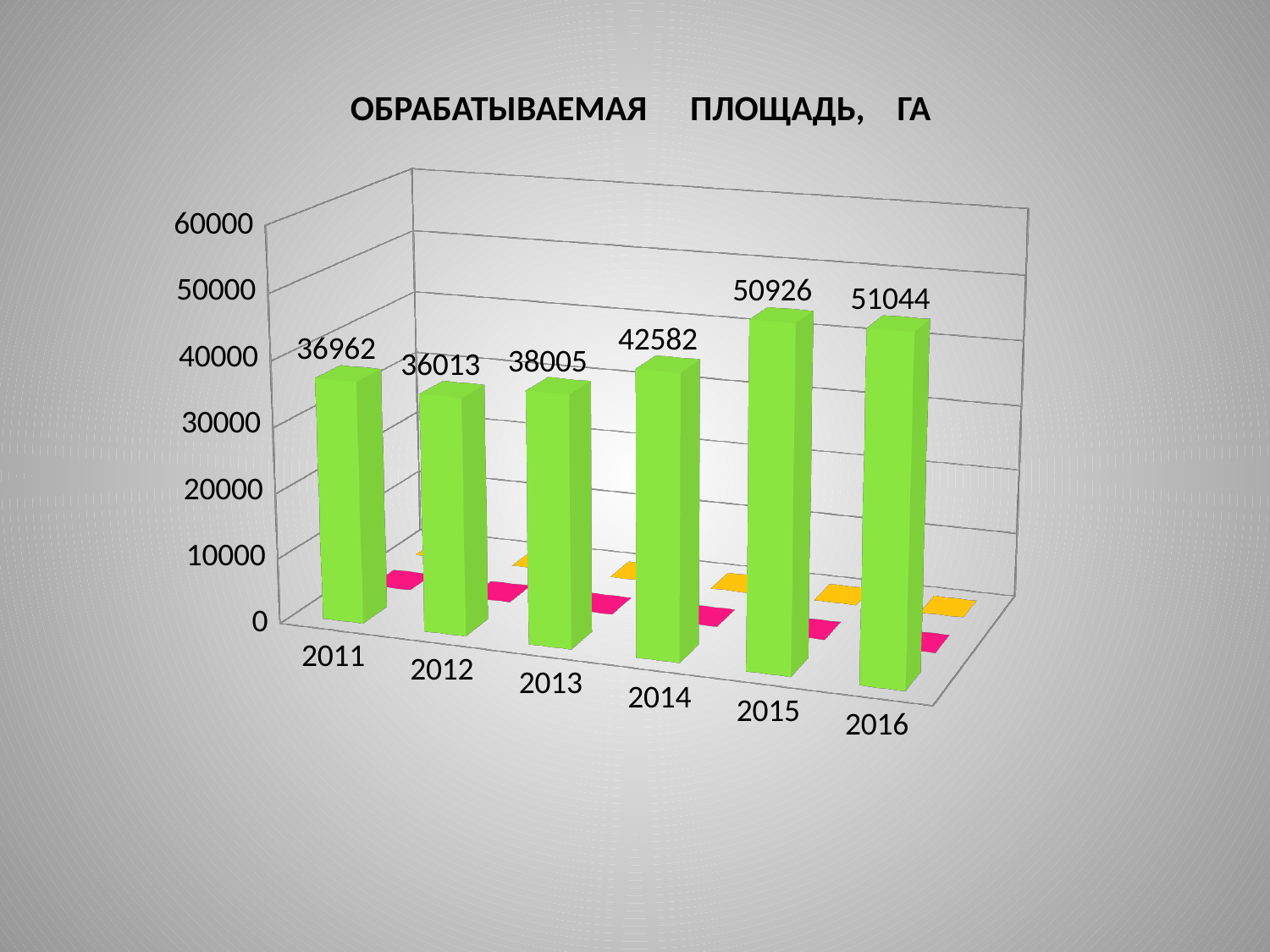
How many years are shown on the x axis? 6 What is the difference between the values for 2015 and 2014? 8344 What is the title of the chart? ОБРАБАТЫВАЕМАЯ ПЛОЩАДЬ, ГА What is the difference between the values for 2016 and 2011? 14082 What is the value for 2016? 51044 Which year has the highest value? 2016 Is the value for 2015 greater or less than 40000? greater What kind of chart is shown on the slide? bar chart What is the value for 2014? 42582 Which year has the lowest value? 2012 What is the value for 2011? 36962 Which is larger, the value for 2013 or the value for 2014? 2014